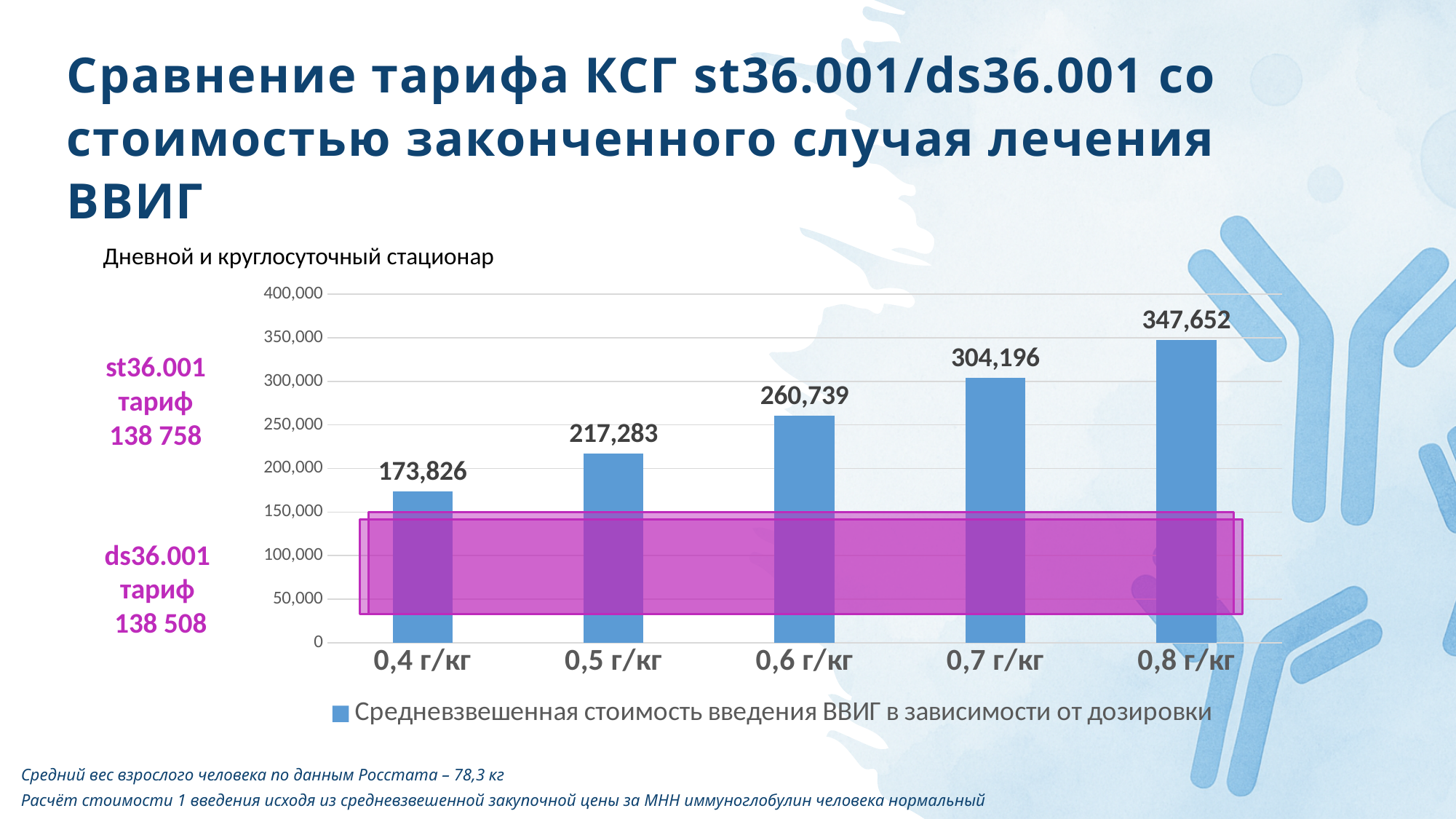
What is the difference between the values for 0,8 г/кг and 0,4 г/кг? 173,826 Which dosage category has the lowest value? 0,4 г/кг Is the value for 0,7 г/кг greater or less than 300,000? greater Which is larger, the value for 0,6 г/кг or the value for 0,5 г/кг? 0,6 г/кг How many dosage categories are shown on the x axis? 5 What kind of chart is shown on the slide? bar chart Which dosage category has the highest value? 0,8 г/кг What is the value for 0,7 г/кг? 304,196 Do the values rise or fall as the dosage increases along the x axis? rise What is the value for 0,4 г/кг? 173,826 What is the difference between the values for 0,5 г/кг and 0,4 г/кг? 43,457 What is the value for 0,6 г/кг? 260,739